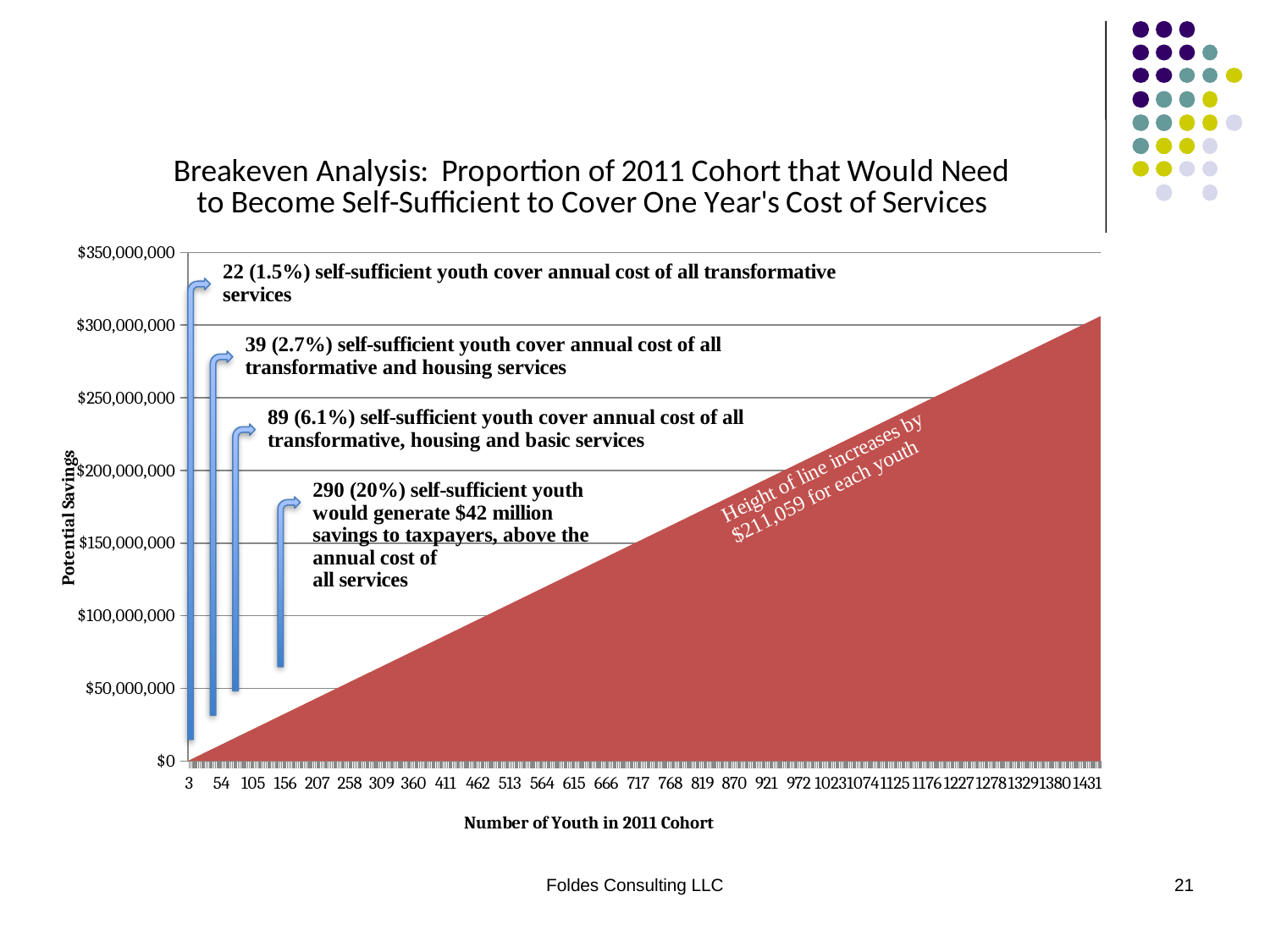
How much savings to taxpayers above the annual cost of all services would 290 (20%) self-sufficient youth generate? $42 million According to the chart annotation, by how much does the height of the line increase for each youth? $211,059 What is the highest value shown on the vertical axis? $350,000,000 Is the potential savings value at 1125 youth greater or less than $200,000,000? greater What is the label of the vertical axis? Potential Savings How many self-sufficient youth are needed to cover the annual cost of all transformative services? 22 (1.5%) Is the potential savings value at 717 youth greater or less than $200,000,000? less What is the label of the horizontal axis? Number of Youth in 2011 Cohort Do the potential savings rise or fall as the number of youth in the 2011 cohort increases? Rise How many self-sufficient youth are needed to cover the annual cost of all transformative and housing services? 39 (2.7%) How many self-sufficient youth are needed to cover the annual cost of all transformative, housing and basic services? 89 (6.1%) What kind of chart is shown on the slide? Area chart